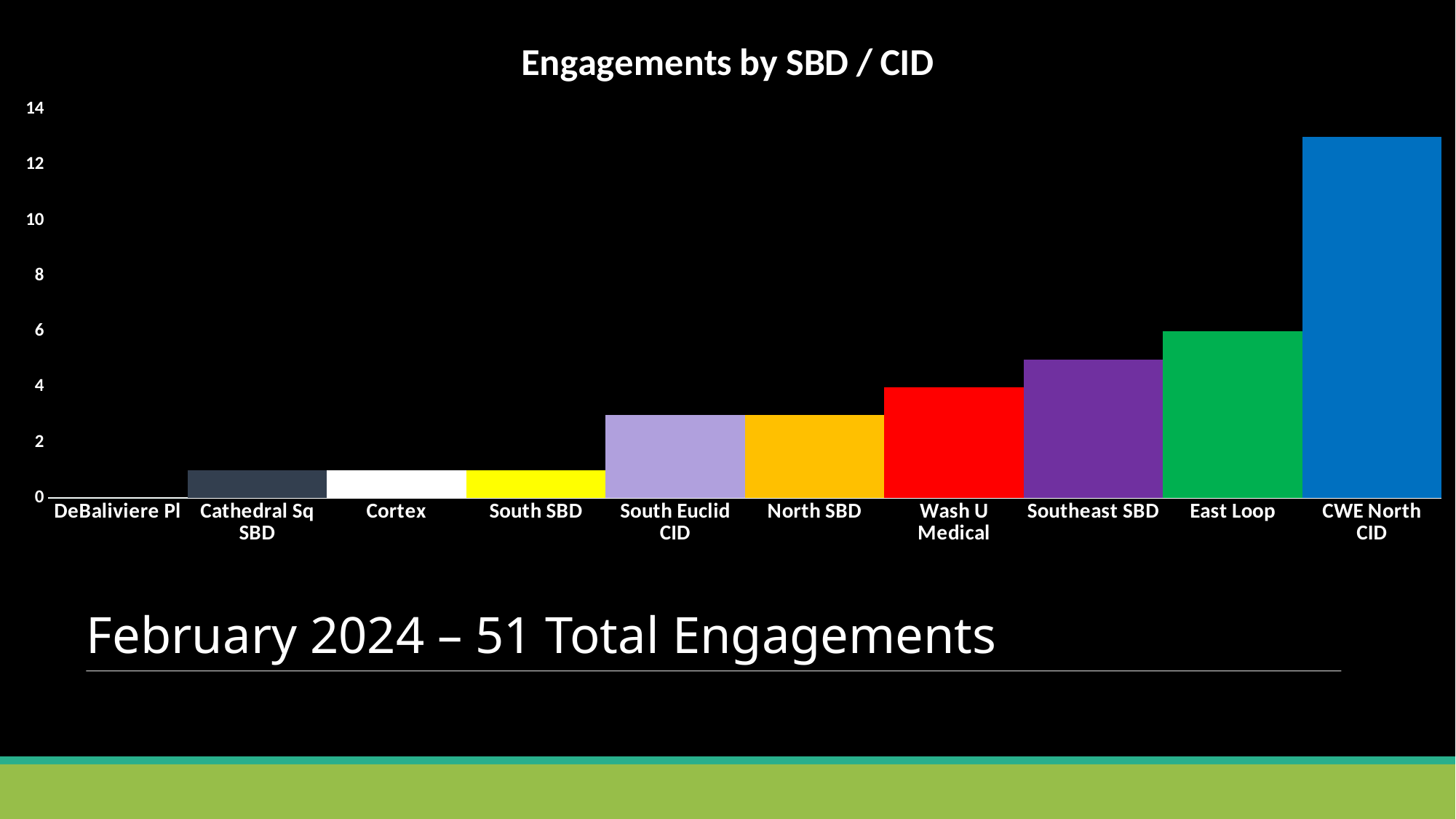
What is the title of the chart? Engagements by SBD / CID Which category has the lowest number of engagements? DeBaliviere Pl Is the value for CWE North CID greater or less than 12? greater Which category has the highest number of engagements? CWE North CID What kind of chart is shown on the slide? bar chart Is the value for Cathedral Sq SBD greater or less than 2? less How many categories are shown on the x axis of the chart? 10 What is the value for Wash U Medical? 4 What is the value for East Loop? 6 Do the values rise or fall moving from left to right along the x axis? rise What is the difference between the values for East Loop and Wash U Medical? 2 Which is larger, the value for East Loop or the value for Southeast SBD? East Loop